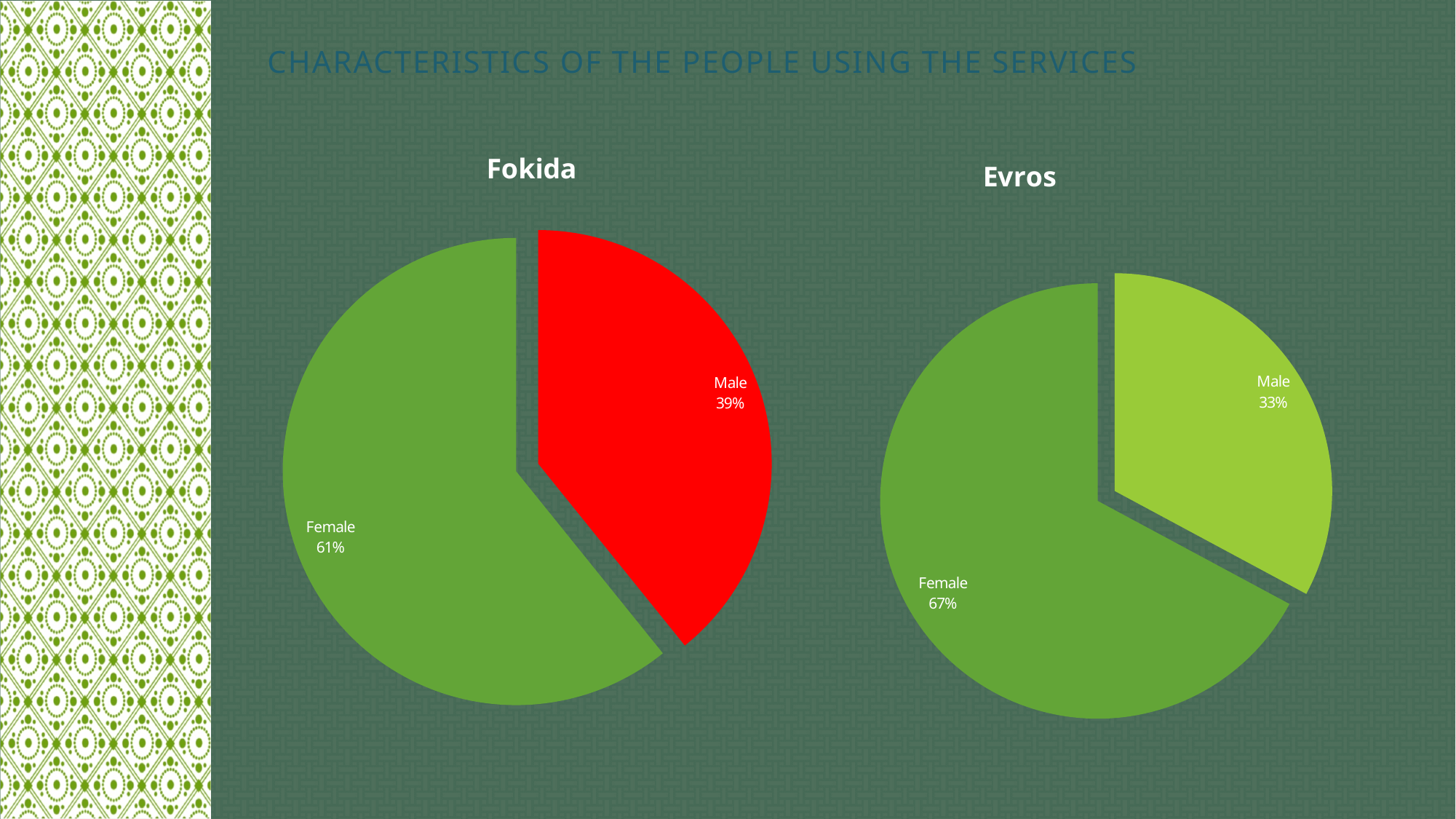
Which chart has the larger Male share, Fokida or Evros? Fokida In the Evros chart, what is the difference between the Female and Male shares? 34% In the Fokida chart, what share of the pie is Female? 61% In the Fokida chart, what share of the pie is Male? 39% In the Fokida chart, what is the difference between the Female and Male shares? 22% In the Fokida chart, which category has the largest slice? Female In the Fokida chart, what colour is the Male slice? Red In the Evros chart, what share of the pie is Female? 67% How many slices does the Evros chart have? 2 What kind of chart is the Fokida chart? Pie chart In the Evros chart, which category has the smallest slice? Male